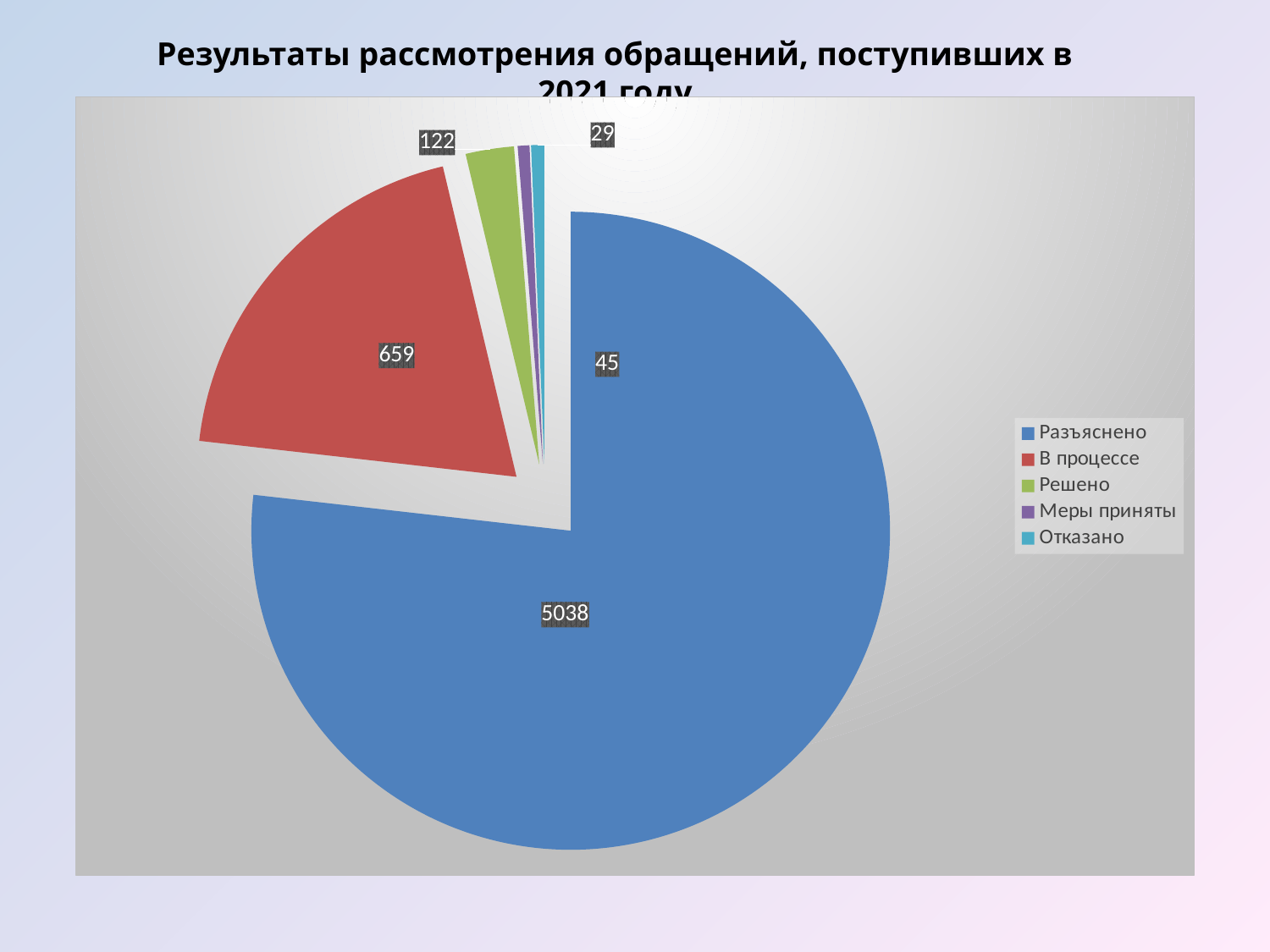
What is the value for В процессе? 659 What is the value for Решено? 122 What is the value for Разъяснено? 5038 How many slices does the pie chart have? 5 How many entries does the legend list? 5 What is the value for Отказано? 29 What kind of chart is shown on the slide? pie chart What is the difference between the values for Разъяснено and В процессе? 4379 Which is larger, the value for Решено or the value for Отказано? Решено What colour is the Разъяснено slice? blue Which category has the largest slice? Разъяснено